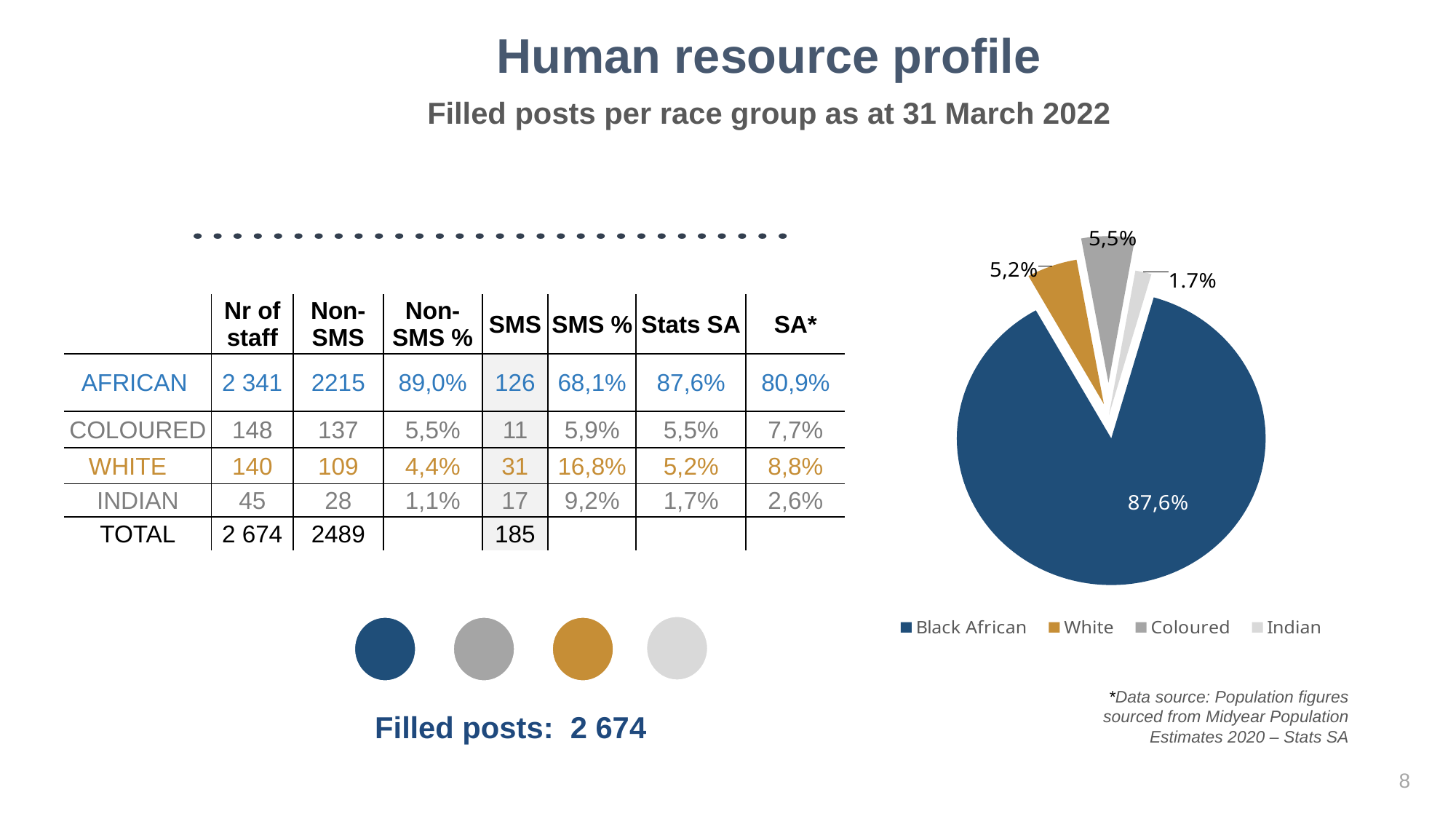
How many slices does the pie chart have? 4 How many entries does the pie chart's legend list? 4 What type of chart is shown on the right of the slide? Pie chart Which group has the largest slice in the pie chart? Black African In the pie chart, which slice is larger: Coloured or White? Coloured In the pie chart, what percentage is shown for the Coloured slice? 5,5% Which group has the smallest slice in the pie chart? Indian In the pie chart, what percentage is shown for the Indian slice? 1.7% In the pie chart, what percentage is shown for the Black African slice? 87,6% What colour is the Black African slice in the pie chart? Dark blue In the pie chart, what is the difference between the Black African share and the Coloured share? 82,1% In the pie chart, what percentage is shown for the White slice? 5,2%